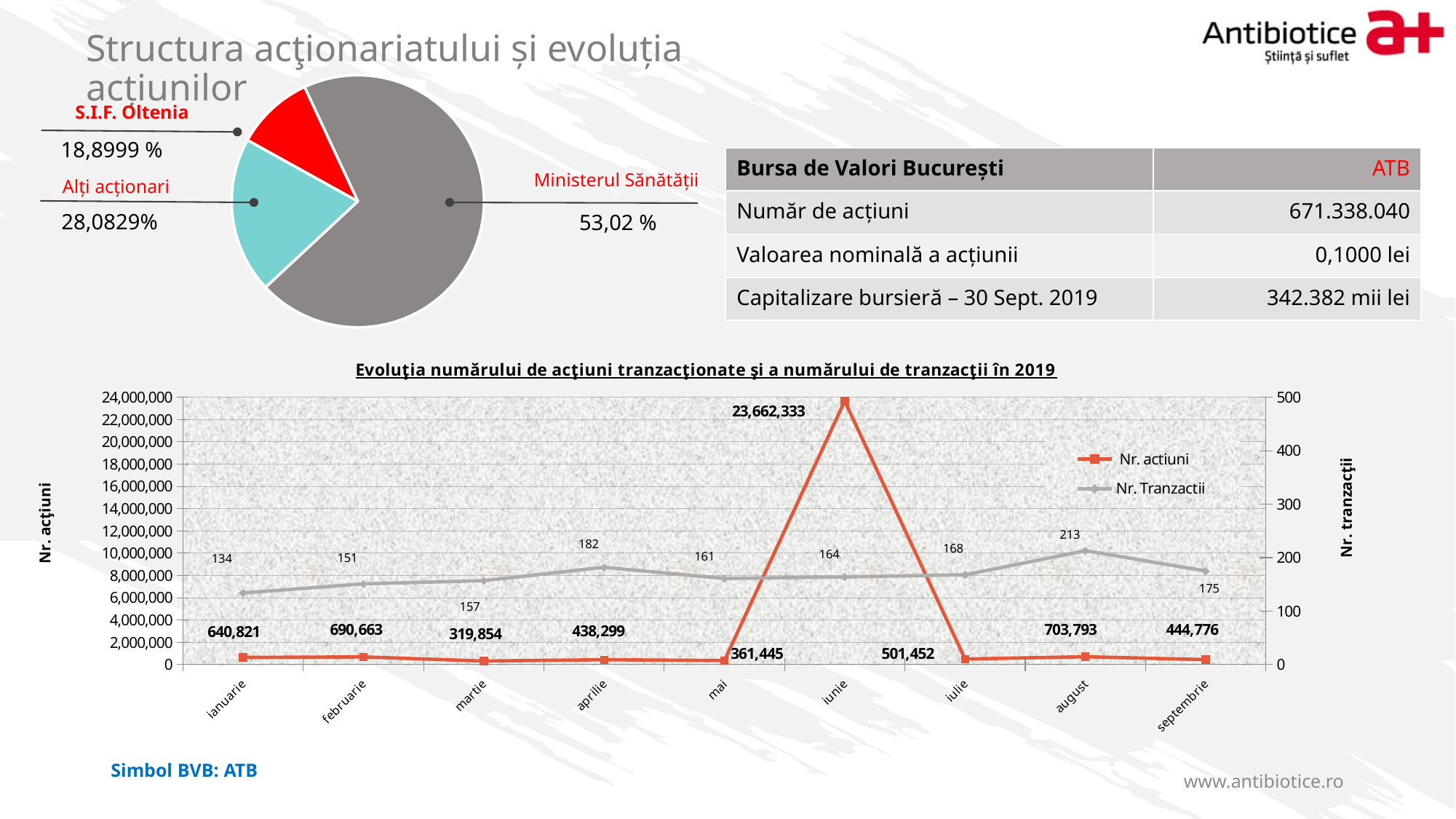
In the pie chart on the shareholder structure, how many slices are there? 3 In the pie chart on the shareholder structure, what share does Ministerul Sănătății hold? 53,02 % In the chart 'Evoluţia numărului de acţiuni tranzacţionate şi a numărului de tranzacţii în 2019', which month has the lowest Nr. actiuni value? martie In the chart 'Evoluţia numărului de acţiuni tranzacţionate şi a numărului de tranzacţii în 2019', what is the Nr. Tranzactii value for august? 213 In the chart 'Evoluţia numărului de acţiuni tranzacţionate şi a numărului de tranzacţii în 2019', what is the difference between the Nr. actiuni values for august and septembrie? 259,017 In the chart 'Evoluţia numărului de acţiuni tranzacţionate şi a numărului de tranzacţii în 2019', which month has the lowest Nr. Tranzactii value? ianuarie In the pie chart on the shareholder structure, which shareholder has the smallest slice? S.I.F. Oltenia In the chart 'Evoluţia numărului de acţiuni tranzacţionate şi a numărului de tranzacţii în 2019', how many series does the legend list? 2 In the pie chart on the shareholder structure, what share does S.I.F. Oltenia hold? 18,8999 % In the chart 'Evoluţia numărului de acţiuni tranzacţionate şi a numărului de tranzacţii în 2019', how many months are plotted on the x axis? 9 In the chart 'Evoluţia numărului de acţiuni tranzacţionate şi a numărului de tranzacţii în 2019', what is the Nr. actiuni value for iunie? 23,662,333 In the pie chart on the shareholder structure, which shareholder has the largest slice? Ministerul Sănătății